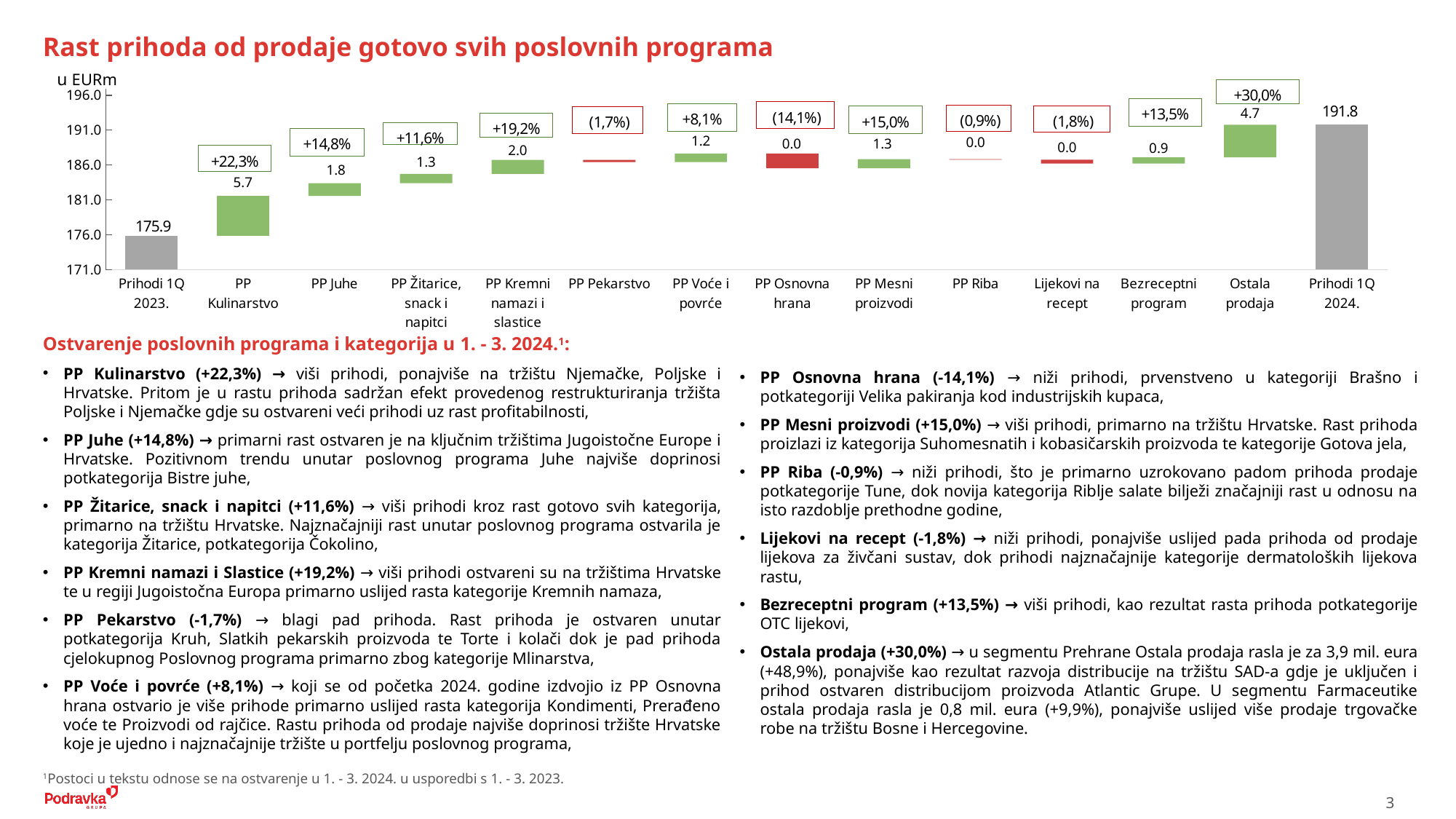
What unit is indicated above the chart's y axis? u EURm What is the value for Prihodi 1Q 2024.? 191.8 Which business program contributes the largest increase in the chart? PP Kulinarstvo What is the difference between Prihodi 1Q 2024. and Prihodi 1Q 2023.? 15.9 What percentage change is shown for Ostala prodaja? +30,0% What is the value shown for PP Kulinarstvo? 5.7 Is the value for Prihodi 1Q 2023. greater or less than 181.0? less How many categories are shown on the x axis of the chart? 14 What is the value for Prihodi 1Q 2023.? 175.9 What percentage change is shown for PP Osnovna hrana? (14,1%) What kind of chart is shown on the slide? bar chart Which is larger, the value for PP Juhe or the value for PP Kremni namazi i slastice? PP Kremni namazi i slastice